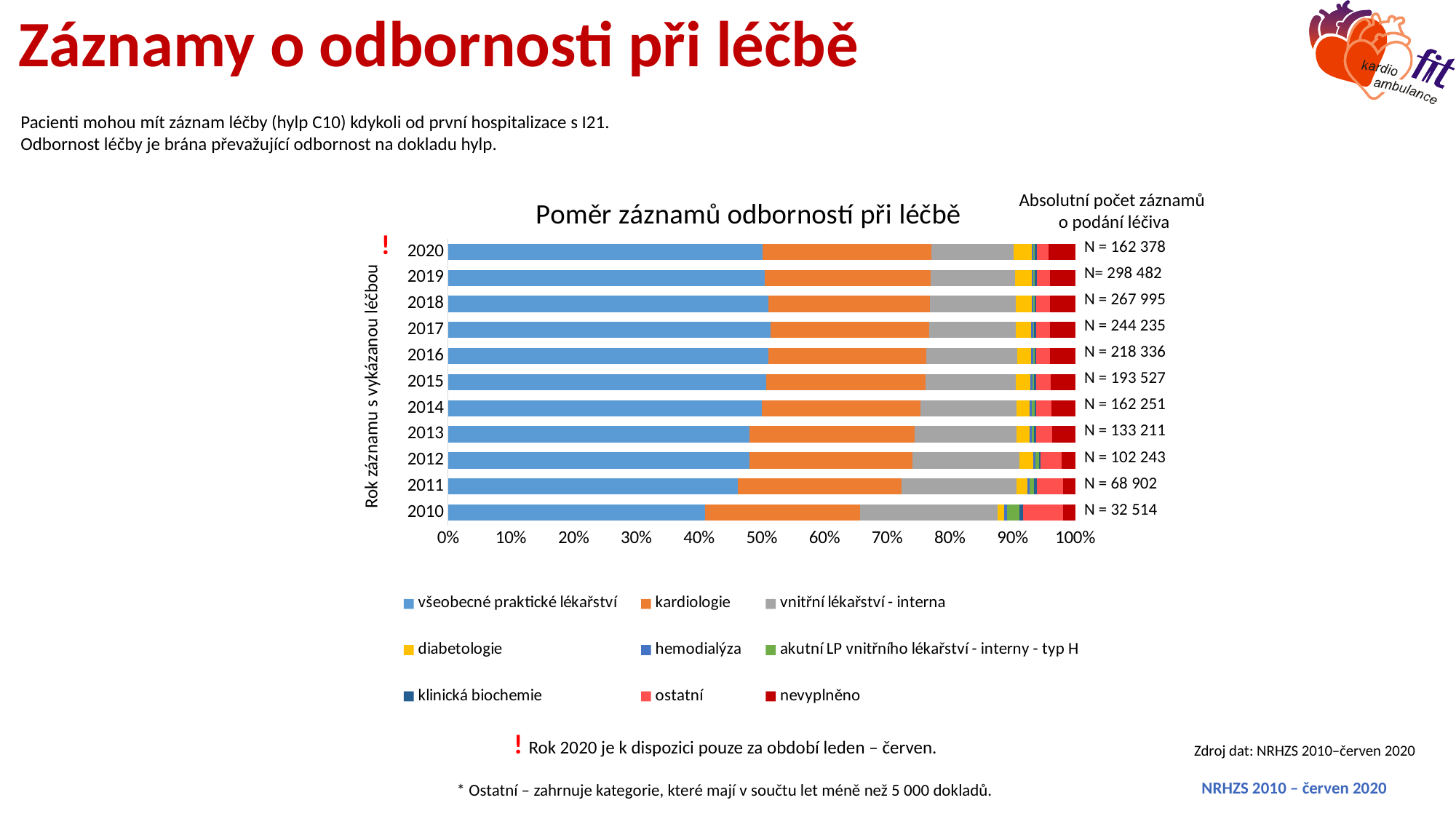
What kind of chart is shown on the slide? bar chart What is the difference between the N values for 2019 and 2018? 30 487 How many years (categories) are plotted on the chart? 11 What is the absolute number of records (N) shown for 2010? N = 32 514 How many series does the legend list? 9 Which year has the lowest absolute number of records (N)? 2010 What is the absolute number of records (N) shown for 2020? N = 162 378 Does the share of všeobecné praktické lékařství increase or decrease from 2010 to 2015? increase Is the share of všeobecné praktické lékařství in 2010 greater or less than 50%? less What is the title of the chart? Poměr záznamů odborností při léčbě Which year has the highest absolute number of records (N)? 2019 In 2010, which share is larger: všeobecné praktické lékařství or kardiologie? všeobecné praktické lékařství